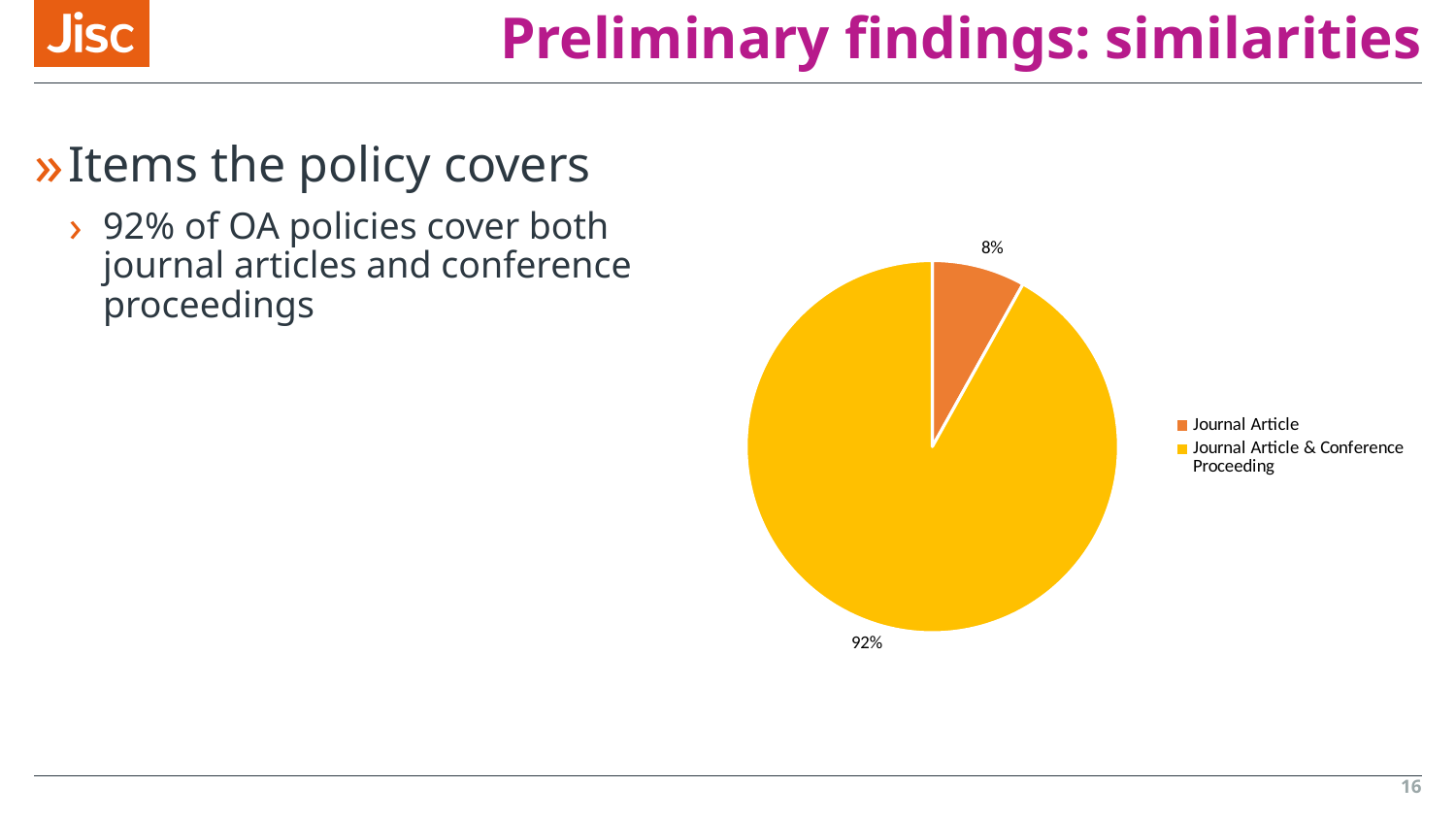
Which slice of the pie is the smallest? Journal Article How many entries does the legend list? 2 Which is larger: the Journal Article slice or the Journal Article & Conference Proceeding slice? Journal Article & Conference Proceeding Which slice of the pie is the largest? Journal Article & Conference Proceeding How many slices does the pie chart have? 2 What kind of chart is shown on the slide? Pie chart What share of the pie does the Journal Article slice represent? 8% What colour is the Journal Article & Conference Proceeding slice? Yellow What is the difference in percentage points between the Journal Article & Conference Proceeding slice and the Journal Article slice? 84 percentage points What colour is the Journal Article slice? Orange What share of the pie does the Journal Article & Conference Proceeding slice represent? 92%